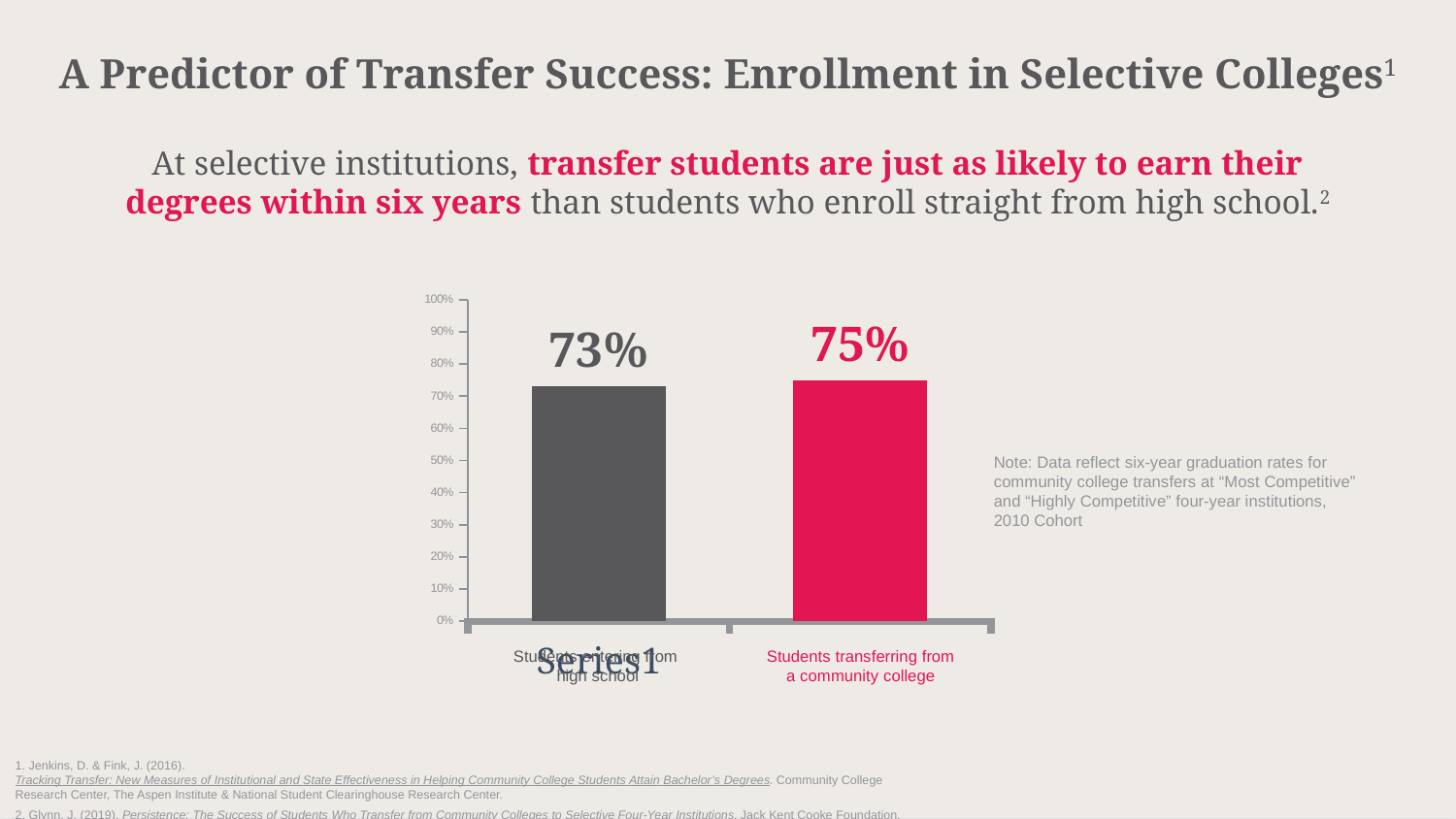
Is the value for students entering from high school greater or less than 50%? greater What is the six-year graduation rate shown for students entering from high school? 73% What is the maximum value shown on the chart's vertical axis? 100% Which category has the lower graduation rate in the chart? Students entering from high school What kind of chart is shown on the slide? Bar chart What colour is the bar for students transferring from a community college? Pink/red What is the six-year graduation rate shown for students transferring from a community college? 75% Is the value for students transferring from a community college greater or less than 80%? less Is the value for students transferring from a community college larger or smaller than the value for students entering from high school? larger How many bars are plotted in the chart? 2 What is the difference in percentage points between the graduation rate for students transferring from a community college and students entering from high school? 2 percentage points Which category has the higher graduation rate in the chart? Students transferring from a community college